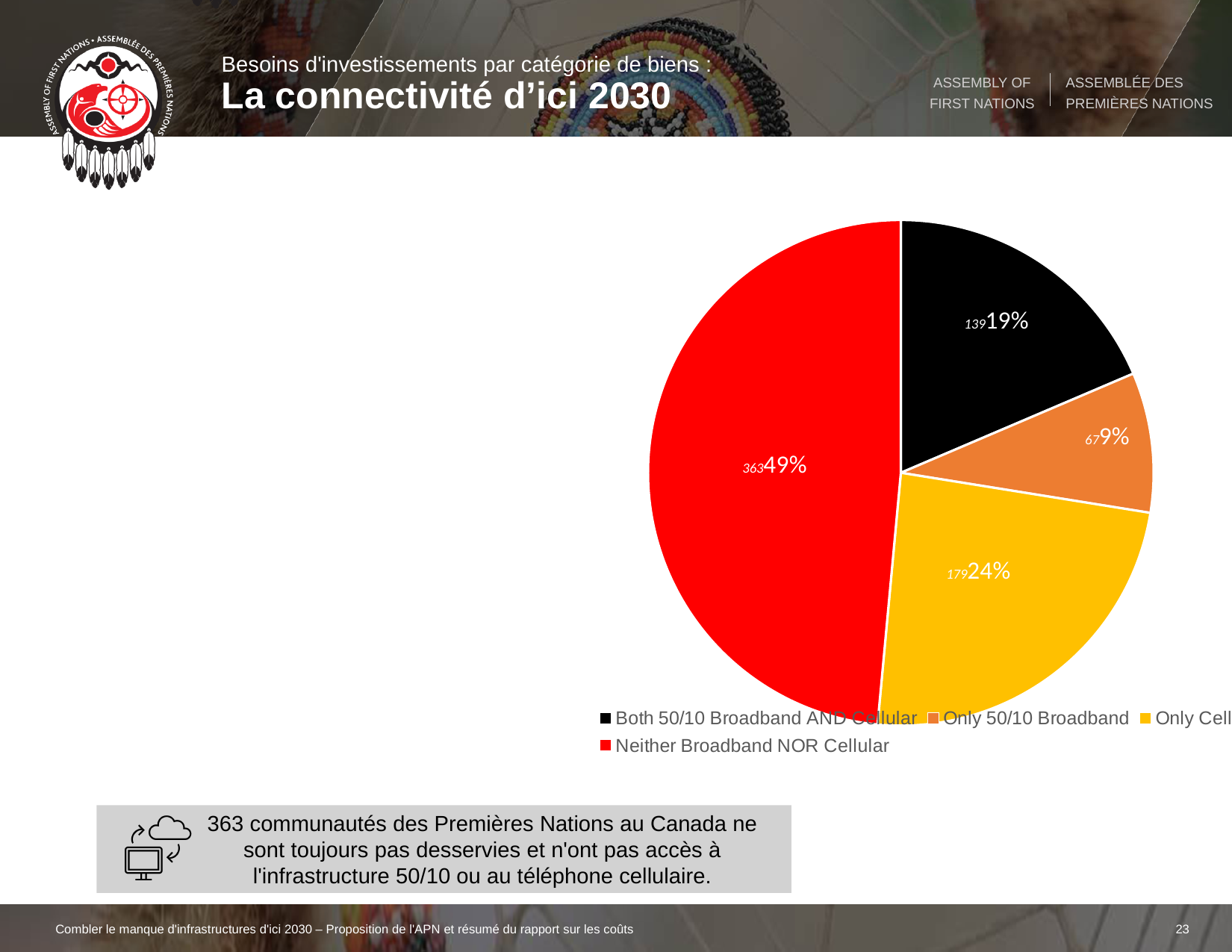
What is the difference between the value for 'Neither Broadband NOR Cellular' and the value for 'Both 50/10 Broadband AND Cellular'? 224 What percentage of the pie is the 'Neither Broadband NOR Cellular' slice? 49% What kind of chart is shown on the slide? pie chart Which is larger: the value for 'Both 50/10 Broadband AND Cellular' or the value for the yellow slice labelled 'Only Cell'? the yellow slice labelled 'Only Cell' How many slices does the pie chart have? 4 What percentage is shown on the yellow slice of the pie? 24% What is the value shown for 'Both 50/10 Broadband AND Cellular'? 139 What share of the pie does 'Only 50/10 Broadband' represent? 9% Which category has the largest slice of the pie? Neither Broadband NOR Cellular Which category has the smallest slice of the pie? Only 50/10 Broadband What colour is the 'Neither Broadband NOR Cellular' slice? red What is the total of the four values shown on the pie chart? 748